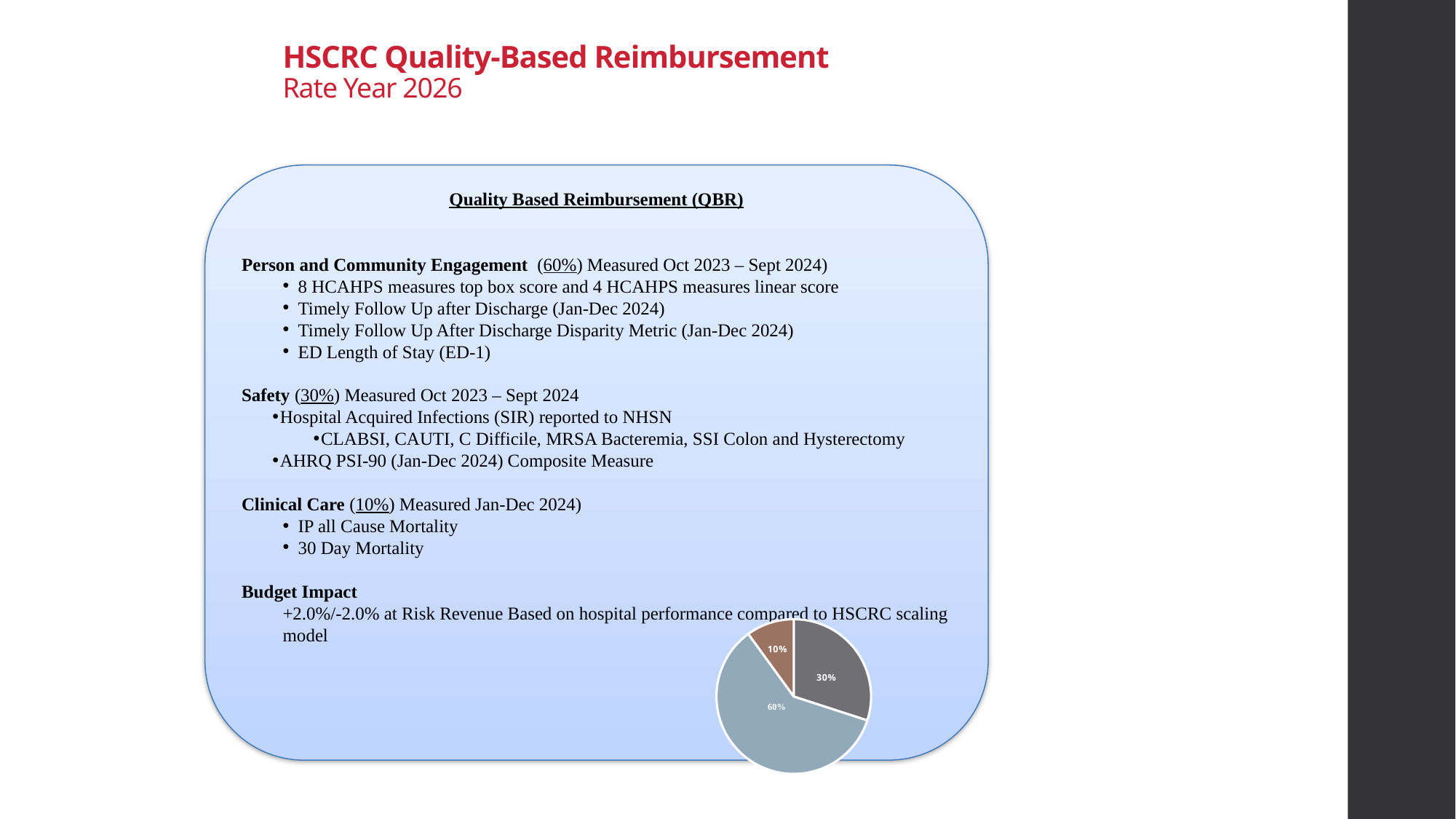
What is the value of the brown slice in the pie chart? 10% What is the value of the largest slice in the pie chart? 60% Which is larger in the pie chart, the dark gray slice or the brown slice? the dark gray slice Does the pie chart have a legend? no How many slices does the pie chart have? 3 What is the difference between the largest and smallest slices in the pie chart? 50% What is the difference between the 60% slice and the 30% slice in the pie chart? 30% Do the three slices of the pie chart add up to 100%? yes What is the value of the blue-gray slice in the pie chart? 60% What is the value of the smallest slice in the pie chart? 10% What kind of chart is shown on the slide? pie chart What is the value of the dark gray slice in the pie chart? 30%